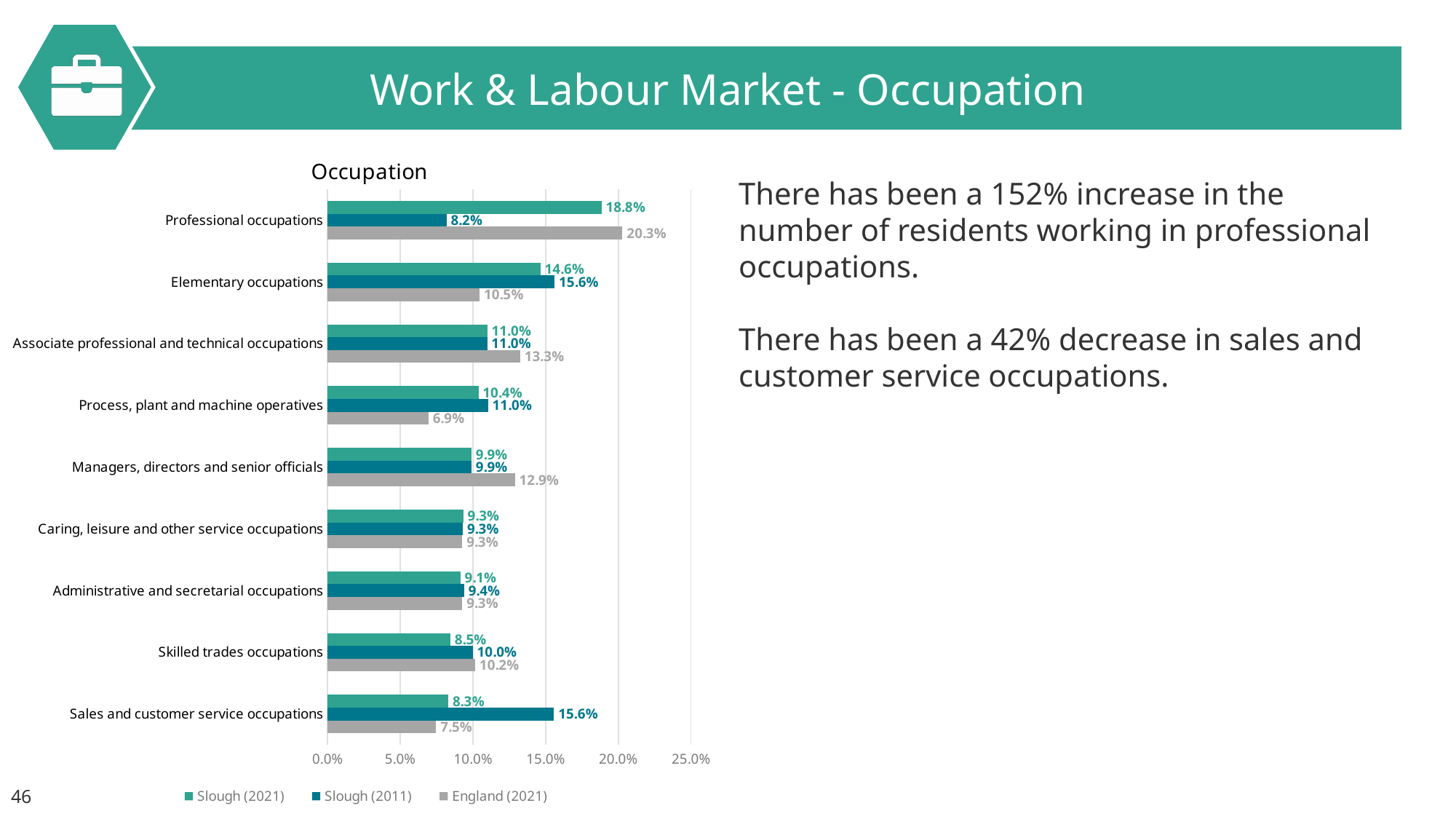
Which occupation has the lowest England (2021) value? Process, plant and machine operatives What is the difference between the Slough (2011) and Slough (2021) values for Sales and customer service occupations? 7.3% How many series does the legend list? 3 How many occupation categories are shown on the chart? 9 What is the Slough (2011) value for Sales and customer service occupations? 15.6% What is the difference between the England (2021) and Slough (2021) values for Professional occupations? 1.5% Which occupation has the highest Slough (2021) value? Professional occupations Which is larger for Elementary occupations: the Slough (2021) value or the England (2021) value? Slough (2021) What is the title of the chart? Occupation What is the England (2021) value for Managers, directors and senior officials? 12.9% What is the Slough (2021) value for Professional occupations? 18.8% What kind of chart is shown on the slide? Bar chart